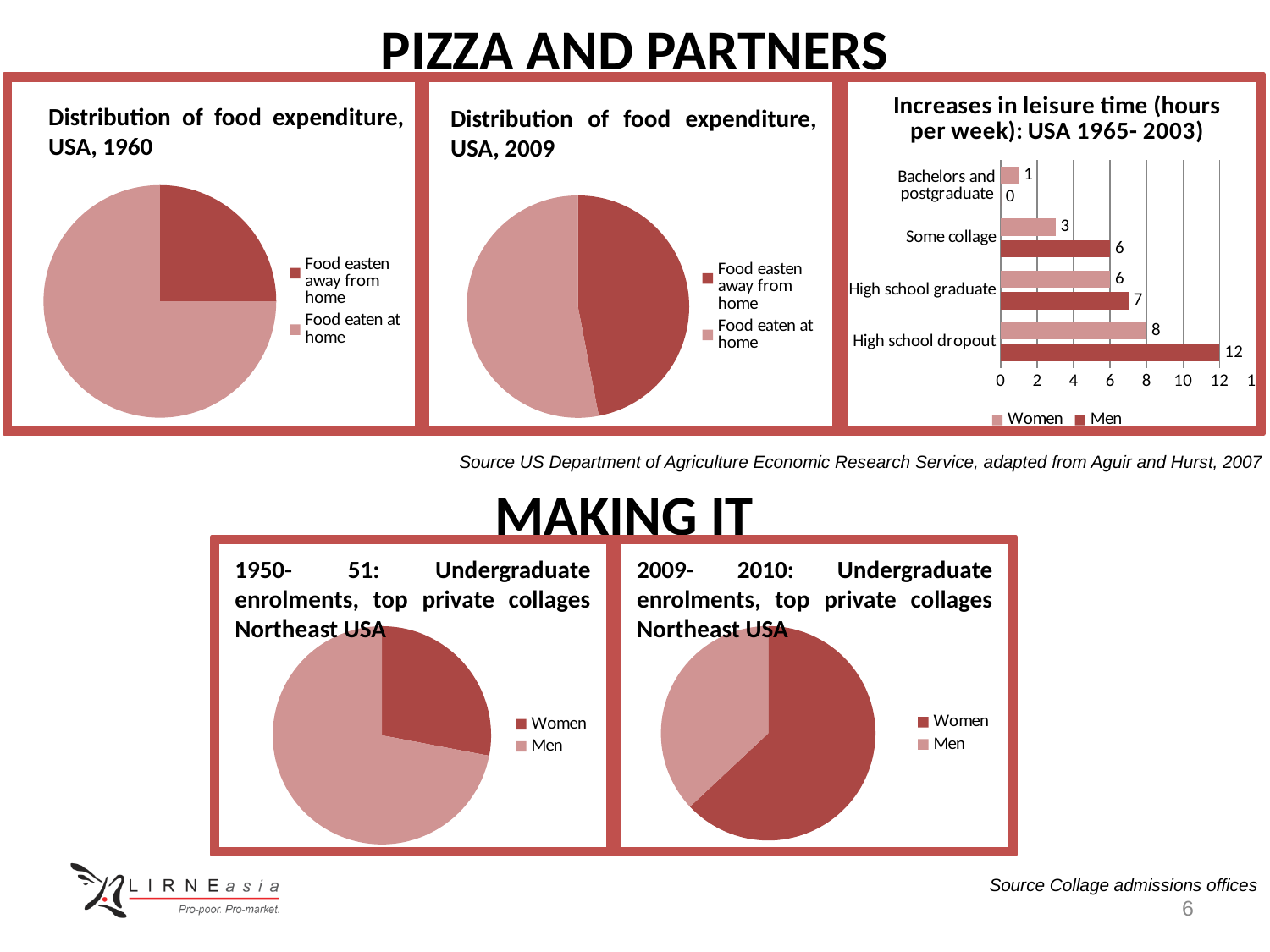
In the '2009- 2010: Undergraduate enrolments, top private collages Northeast USA' chart, which slice is larger, Women or Men? Women How many categories are shown in the 'Increases in leisure time (hours per week): USA 1965- 2003' chart? 4 In the 'Distribution of food expenditure, USA, 1960' chart, which slice is larger, Food eaten at home or Food easten away from home? Food eaten at home In the 'Increases in leisure time (hours per week): USA 1965- 2003' chart, which category has the lowest value for Men? Bachelors and postgraduate In the 'Increases in leisure time (hours per week): USA 1965- 2003' chart, what is the value for Men in the High school dropout category? 12 In the 'Increases in leisure time (hours per week): USA 1965- 2003' chart, which category has the highest value for Women? High school dropout In the 'Increases in leisure time (hours per week): USA 1965- 2003' chart, which is larger for High school graduate, the Women value or the Men value? Men In the 'Increases in leisure time (hours per week): USA 1965- 2003' chart, what is the difference between the Men and Women values for High school dropout? 4 How many series does the legend of the 'Increases in leisure time (hours per week): USA 1965- 2003' chart list? 2 In the 'Increases in leisure time (hours per week): USA 1965- 2003' chart, what is the value for Women in the Some collage category? 3 In the 'Increases in leisure time (hours per week): USA 1965- 2003' chart, what is the value for Men in the Bachelors and postgraduate category? 0 What kind of chart is 'Increases in leisure time (hours per week): USA 1965- 2003'? Bar chart